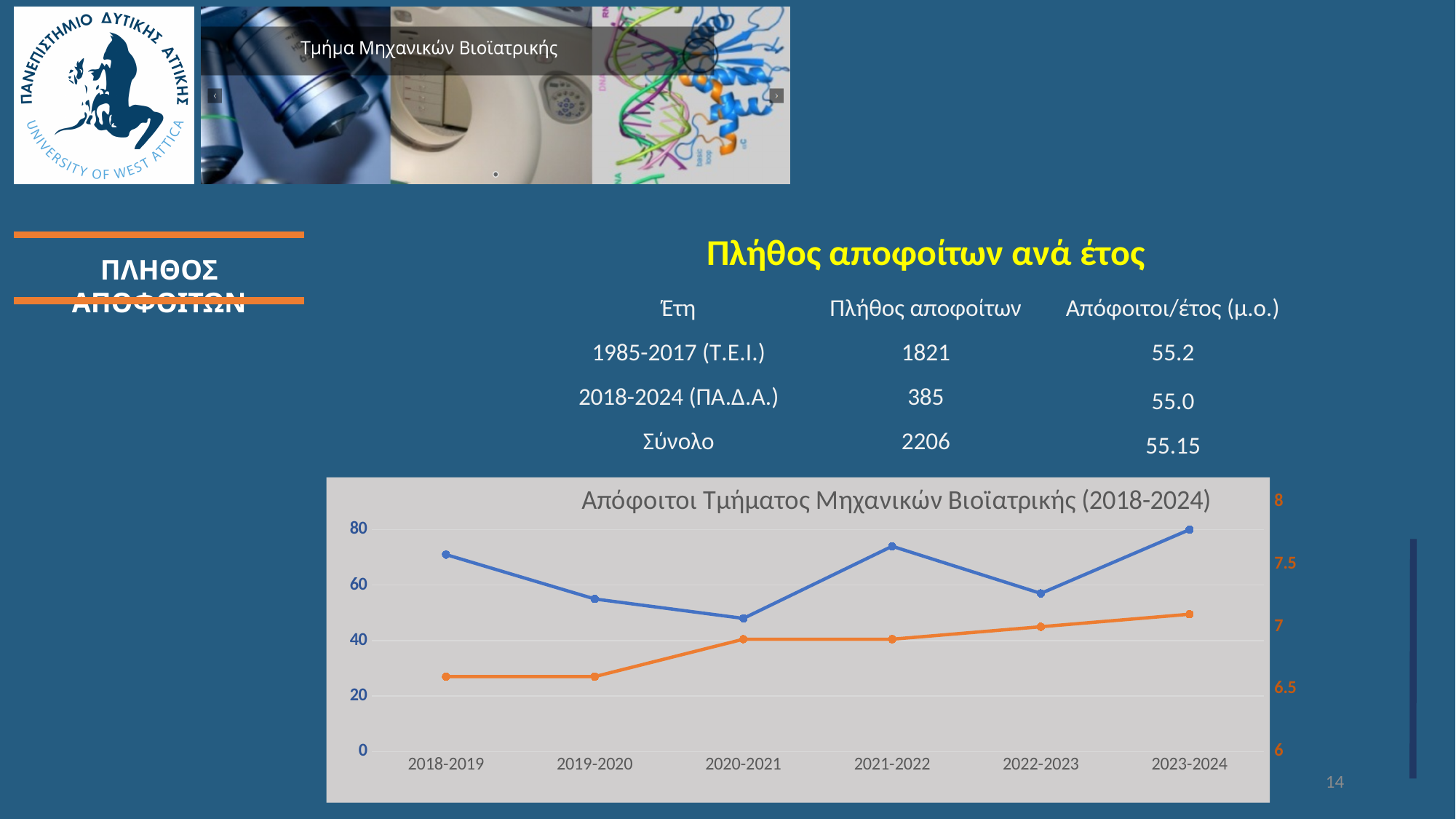
Is the value of the orange line (right axis) for 2023-2024 greater or less than 7? greater How many lines are plotted in the chart? 2 Is the value of the blue line for 2021-2022 greater or less than 60? greater What is the title of the chart on the slide? Απόφοιτοι Τμήματος Μηχανικών Βιοϊατρικής (2018-2024) How many academic years are shown on the x axis of the chart? 6 Is the value of the blue line for 2020-2021 greater or less than 60? less What kind of chart is shown on the slide? Line chart Does the orange line generally rise or fall from 2018-2019 to 2023-2024? Rise In which academic year does the blue line reach its highest value? 2023-2024 Which is larger for the blue line: the value for 2019-2020 or the value for 2021-2022? 2021-2022 In which academic year does the blue line reach its lowest value? 2020-2021